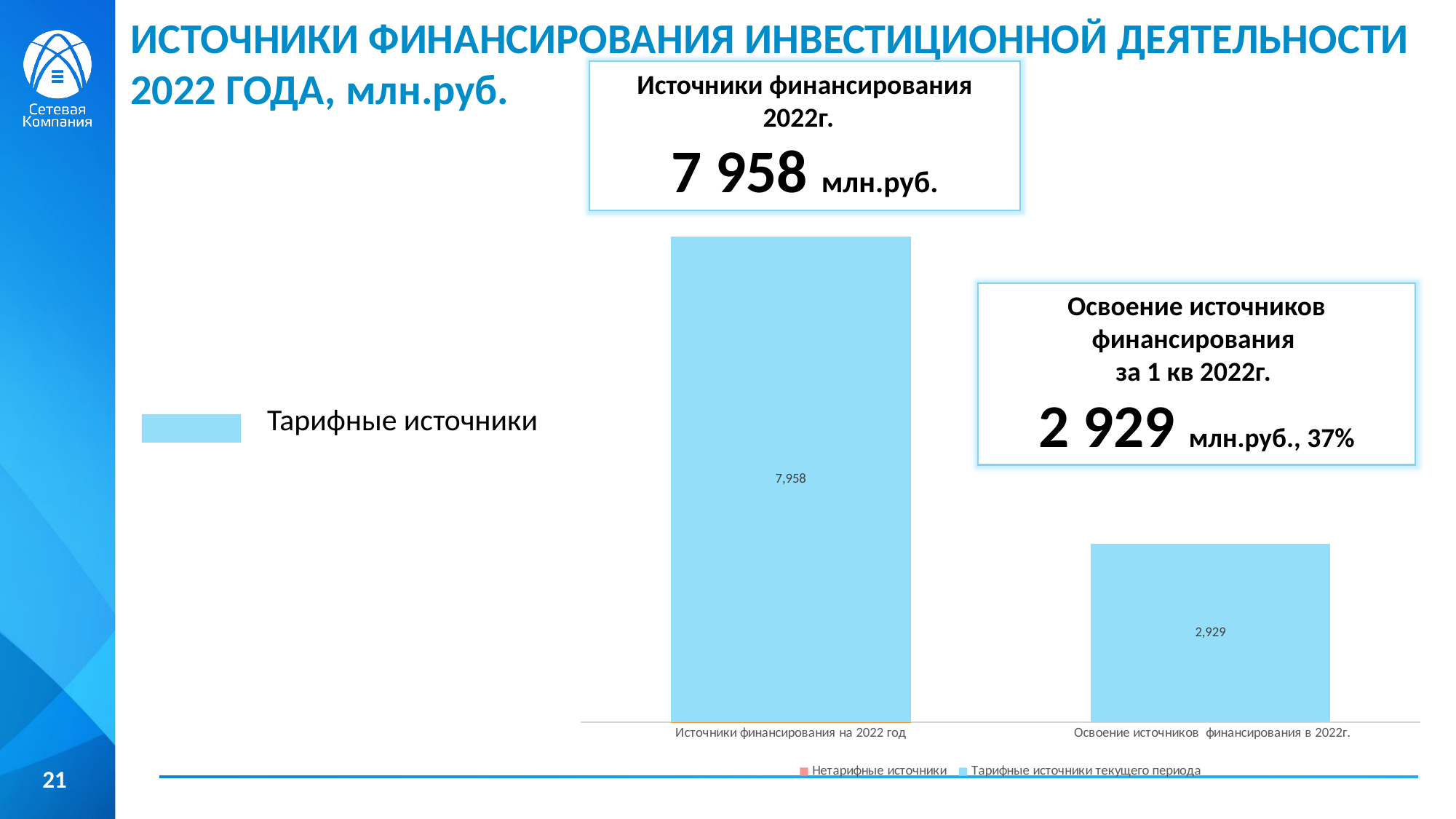
What kind of chart is shown on the slide? Bar chart How many categories are shown on the x axis of the chart? 2 What is the value of the bar labelled "Источники финансирования на 2022 год"? 7,958 What is the value of the bar labelled "Освоение источников финансирования в 2022г."? 2,929 What is the difference between the values for "Источники финансирования на 2022 год" and "Освоение источников финансирования в 2022г."? 5,029 Which category has the highest bar? Источники финансирования на 2022 год Do the bar values rise or fall from left to right along the x axis? Fall What are the two series names listed in the chart legend? Нетарифные источники; Тарифные источники текущего периода Which category has the lowest bar? Освоение источников финансирования в 2022г. Which is larger: the value for "Источники финансирования на 2022 год" or the value for "Освоение источников финансирования в 2022г."? Источники финансирования на 2022 год How many series does the chart legend list? 2 What percentage is shown in the callout box for "Освоение источников финансирования за 1 кв 2022г."? 37%